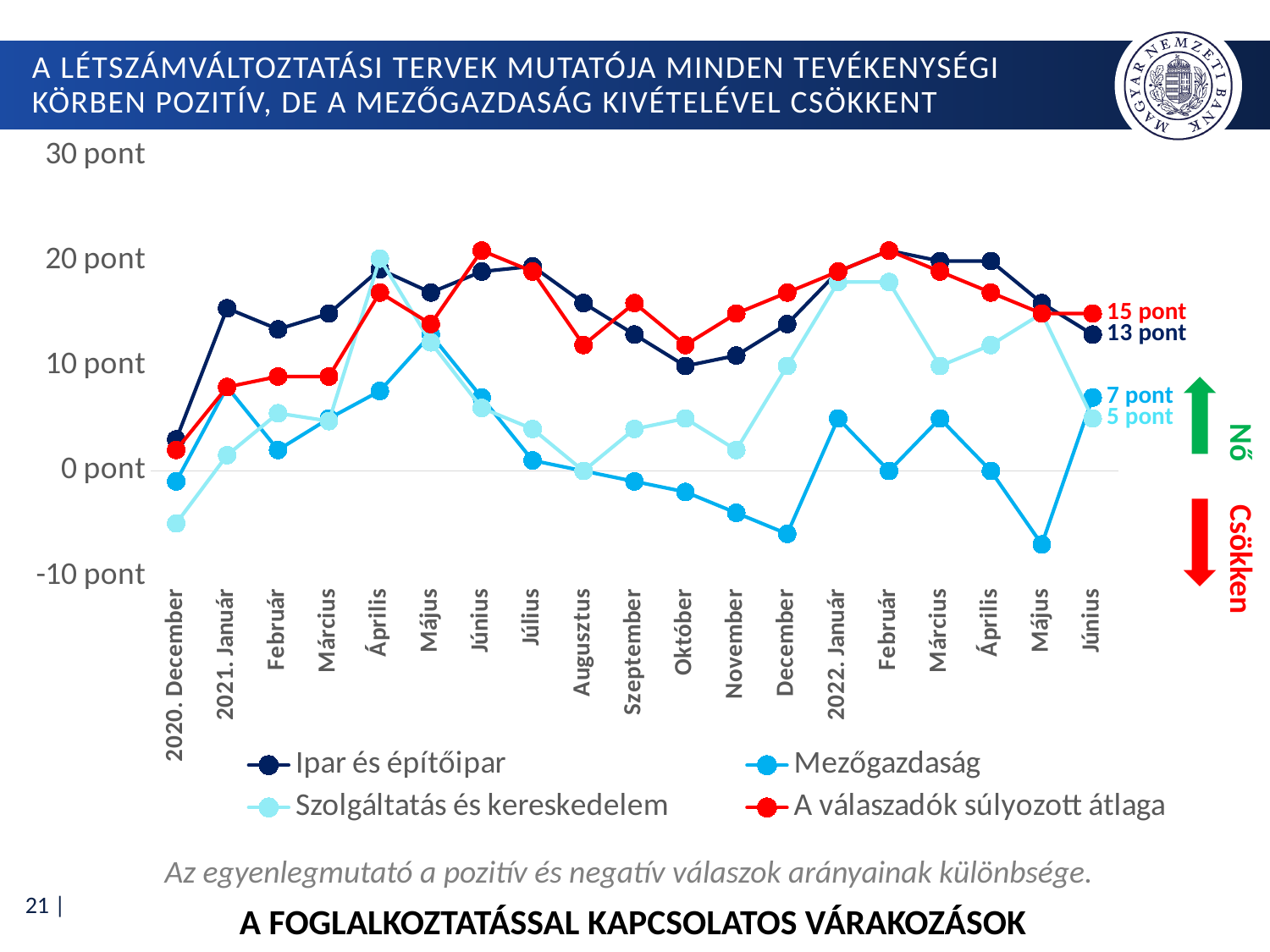
What is the value of 'Mezőgazdaság' in 2022 Június? 7 pont What is the value of 'A válaszadók súlyozott átlaga' in 2022 Június? 15 pont In 2022 Június, which is larger: 'Mezőgazdaság' or 'Szolgáltatás és kereskedelem'? Mezőgazdaság Is the value for 'Mezőgazdaság' in 2022 Május greater or less than 0 pont? less What is the value of 'Szolgáltatás és kereskedelem' in 2022 Június? 5 pont How many months (points) are shown along the x axis? 19 Which series is drawn in red? A válaszadók súlyozott átlaga In 2022 Június, what is the difference between 'A válaszadók súlyozott átlaga' and 'Ipar és építőipar'? 2 pont What kind of chart is shown on the slide? line chart How many series does the legend list? 4 Is the value for 'Ipar és építőipar' in 2021 Április greater or less than 10 pont? greater What is the value of 'Ipar és építőipar' in 2022 Június? 13 pont